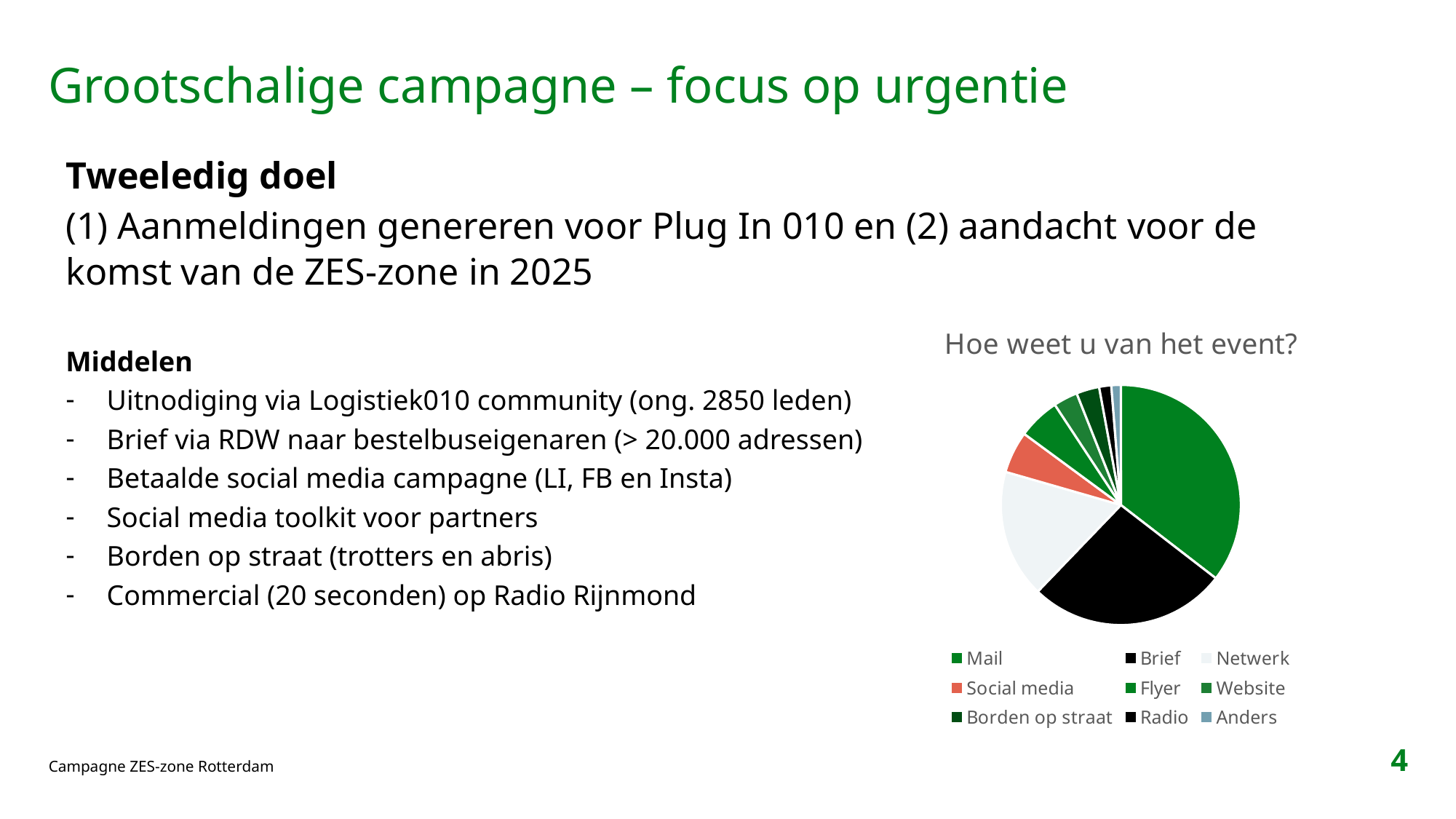
Which slice is larger in the pie chart, Mail or Social media? Mail Which category is shown in red/orange in the pie chart? Social media Which slice is larger in the pie chart, Brief or Netwerk? Brief Which slice is larger in the pie chart, Netwerk or Social media? Netwerk What kind of chart is shown on the slide? pie chart What is the title of the pie chart? Hoe weet u van het event? Which category has the largest slice in the pie chart? Mail How many categories does the legend of the pie chart list? 9